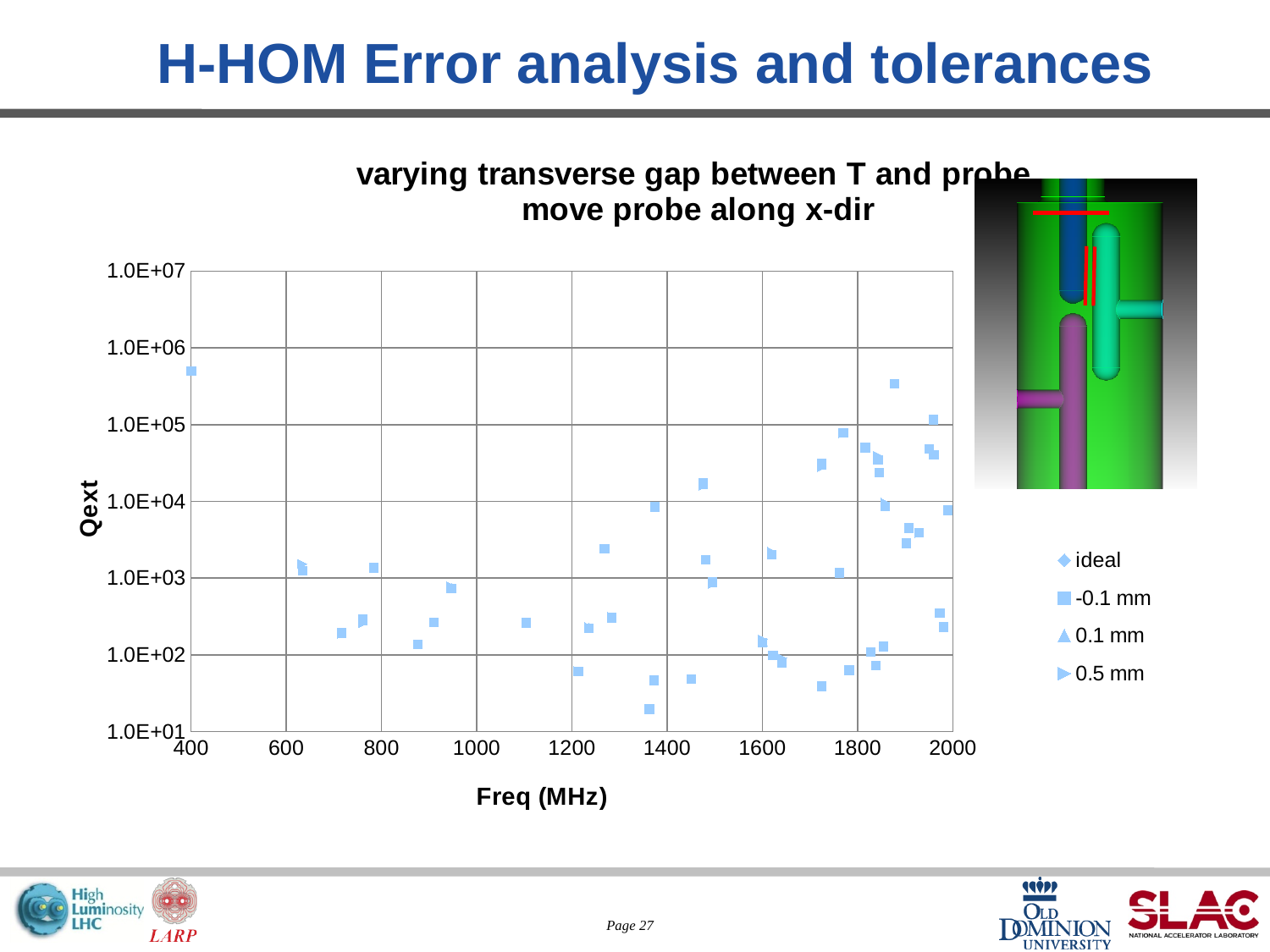
Is the Qext value of the lowest point plotted near 1360 MHz greater or less than 1.0E+02? less Is the Qext value of the point plotted near 1480 MHz at the top of that cluster greater or less than 1.0E+04? greater How many series does the chart legend list? 4 What kind of chart is shown on the slide? scatter chart What is the title of the chart? varying transverse gap between T and probe move probe along x-dir Is the Qext value of the point plotted near 1720 MHz at the bottom of that cluster greater or less than 1.0E+02? less What is the label of the chart's x axis? Freq (MHz) What is the highest value shown on the x axis of the chart? 2000